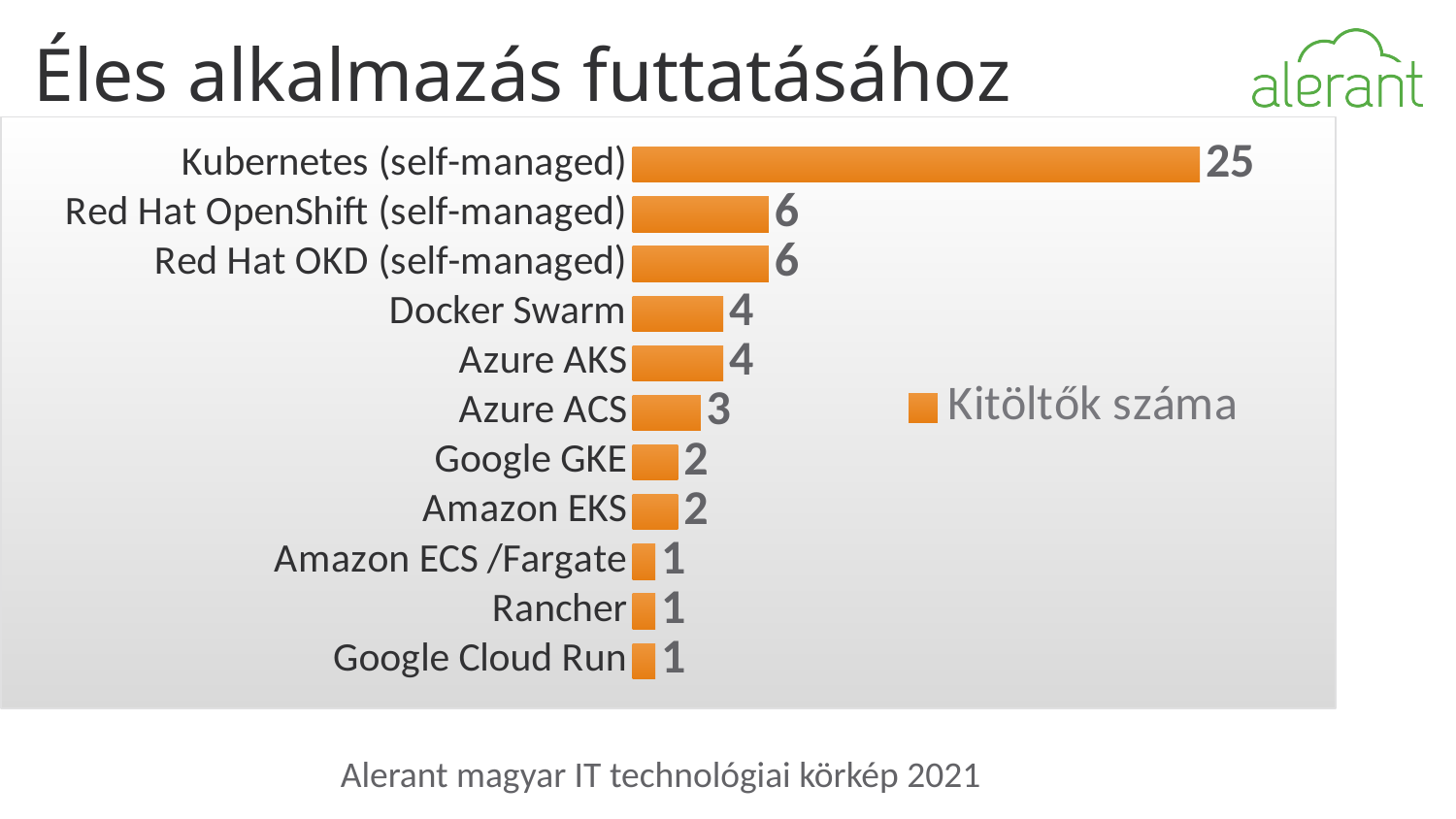
Which is larger, the value for Azure AKS or the value for Azure ACS? Azure AKS How many categories are shown in the chart? 11 Which category has the highest value? Kubernetes (self-managed) What is the difference between the values for Kubernetes (self-managed) and Red Hat OpenShift (self-managed)? 19 What is the value for Amazon EKS? 2 What is the value for Docker Swarm? 4 How many series does the legend list? 1 What is the value for Azure ACS? 3 What is the difference between the values for Docker Swarm and Google GKE? 2 What kind of chart is shown on the slide? Bar chart What is the value for Kubernetes (self-managed)? 25 What is the legend entry shown in the chart? Kitöltők száma